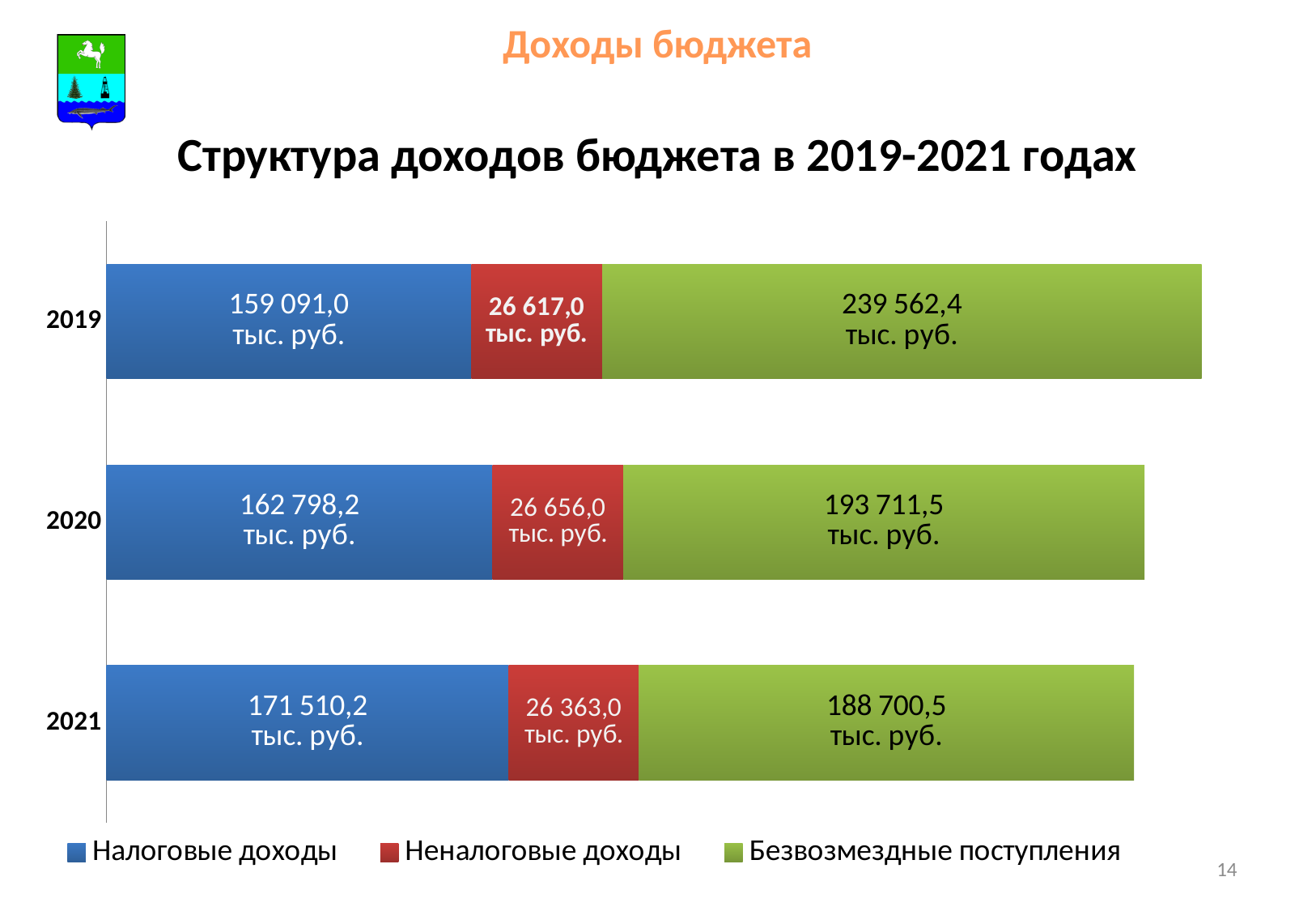
In which year is the value of Безвозмездные поступления the lowest? 2021 How many years (categories) are shown in the chart? 3 What is the value of Налоговые доходы for 2019? 159 091,0 тыс. руб. What is the difference between Налоговые доходы in 2021 and in 2019? 12 419,2 тыс. руб. What type of chart is shown on the slide? Stacked bar chart What is the value of Безвозмездные поступления for 2020? 193 711,5 тыс. руб. What is the value of Неналоговые доходы for 2021? 26 363,0 тыс. руб. What is the total of the stacked bar for 2020? 383 165,7 тыс. руб. Do the values of Налоговые доходы rise or fall from 2019 to 2021? Rise How many series does the legend list? 3 Which is larger: Безвозмездные поступления in 2019 or in 2021? 2019 In which year is the value of Налоговые доходы the highest? 2021